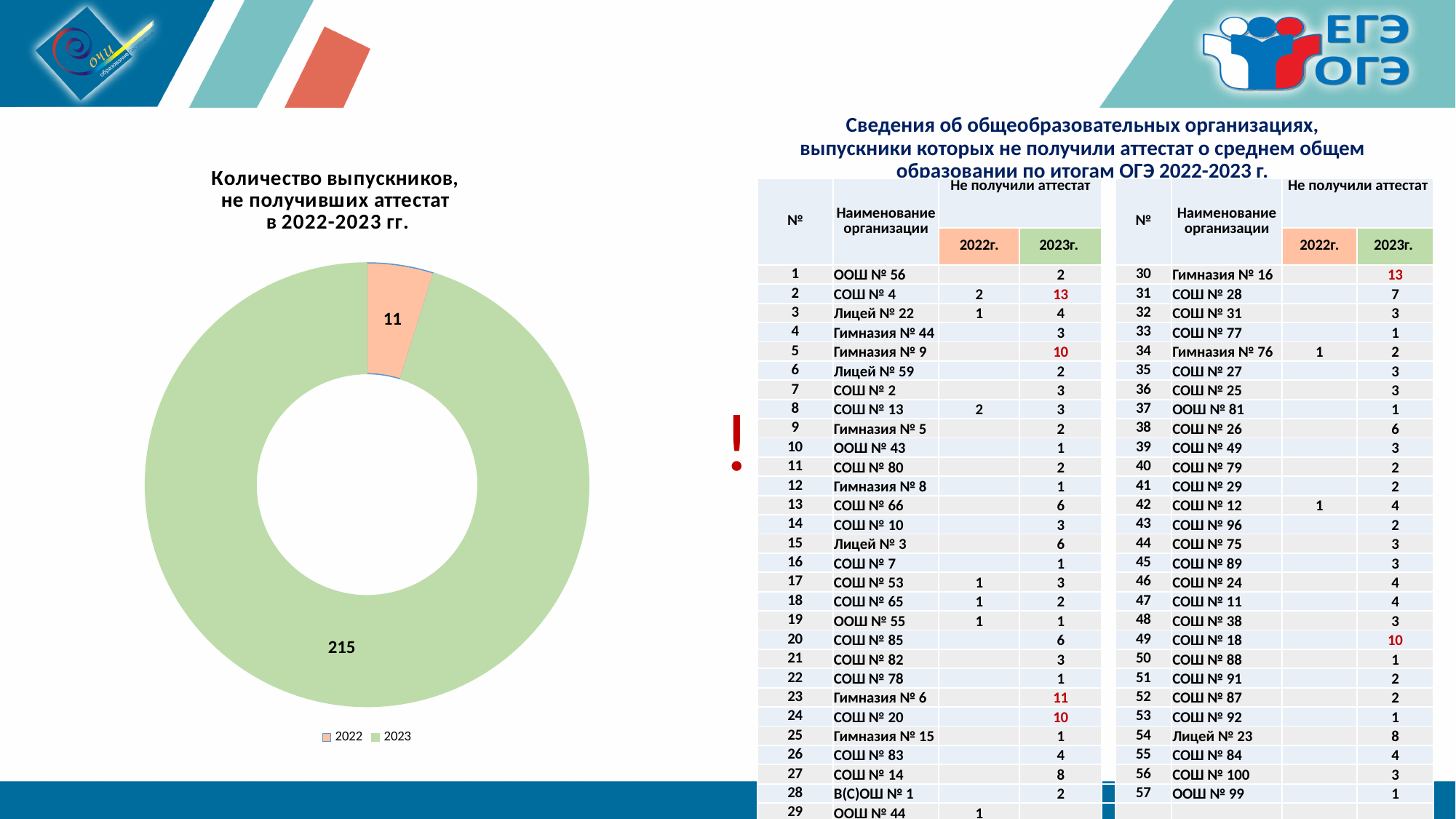
In the doughnut chart on the left, which year has the smaller value? 2022 In the doughnut chart on the left, what is the value shown for 2022? 11 In the doughnut chart on the left, what is the total of the two slices? 226 How many slices does the doughnut chart on the left have? 2 How many entries does the legend of the chart on the left list? 2 What type of chart is shown on the left of the slide? doughnut (ring) chart In the doughnut chart on the left, what is the value shown for 2023? 215 In the doughnut chart on the left, which year has the larger value? 2023 What is the title of the doughnut chart on the left? Количество выпускников, не получивших аттестат в 2022-2023 гг. In the doughnut chart on the left, what is the difference between the 2023 value and the 2022 value? 204 In the doughnut chart on the left, is the value for 2022 larger or smaller than the value for 2023? smaller